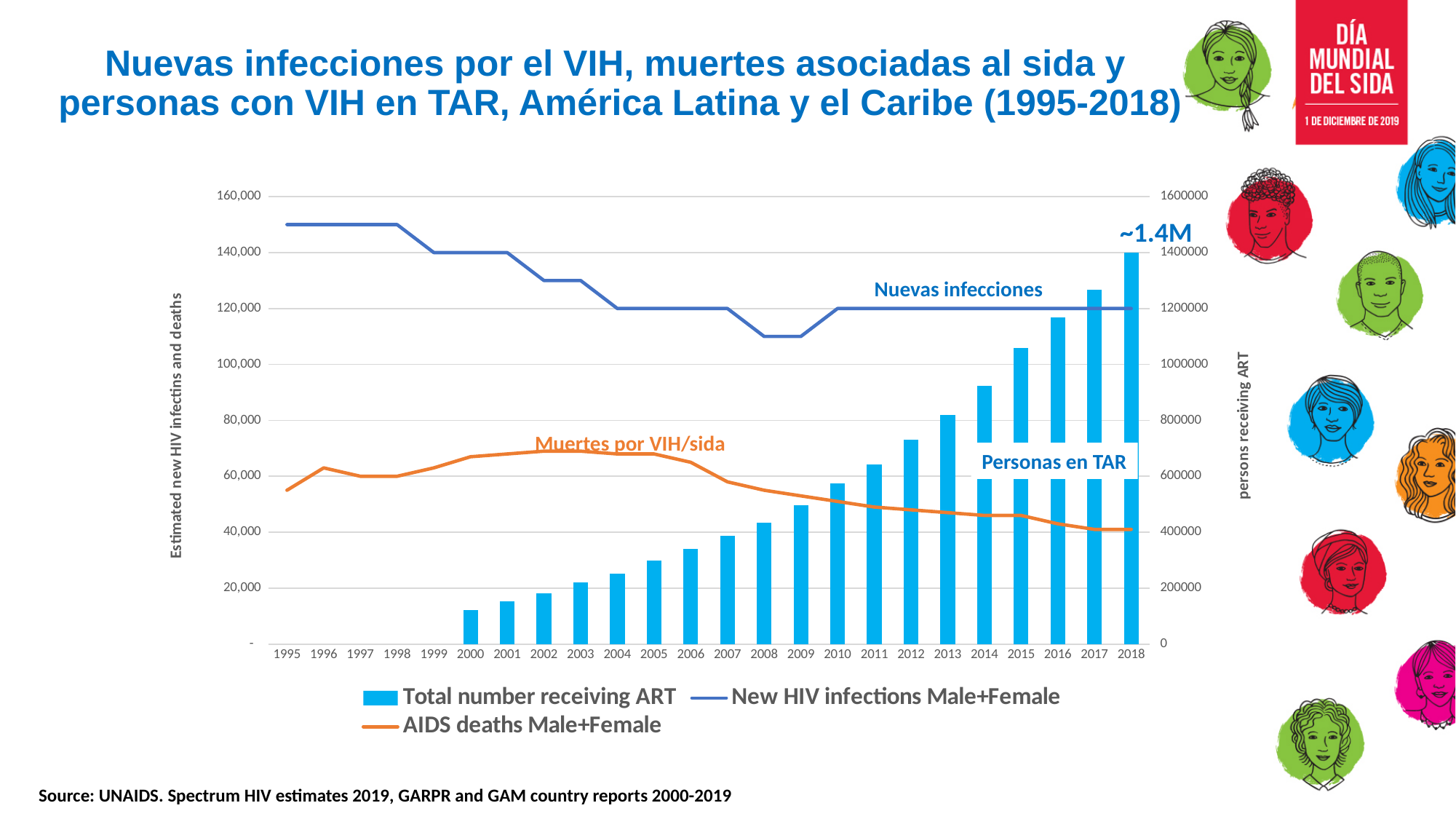
What kind of chart is shown on the slide? A combined bar and line chart Which is larger, new HIV infections in 1995 or in 2018? 1995 Is the total number receiving ART in 2000 greater or less than 200000? less Is the total number receiving ART in 2010 greater or less than 400000? greater Which is larger, AIDS deaths in 2005 or in 2018? 2005 Which series is drawn as an orange line? AIDS deaths Male+Female How many years are shown along the x axis? 24 In which year is the total number receiving ART highest? 2018 Is the number of AIDS deaths in 2018 greater or less than 60,000? less In which year is the total number receiving ART lowest among the years with a bar? 2000 How many series does the legend list? 3 Do the bars for total number receiving ART rise or fall from 2000 to 2018? rise